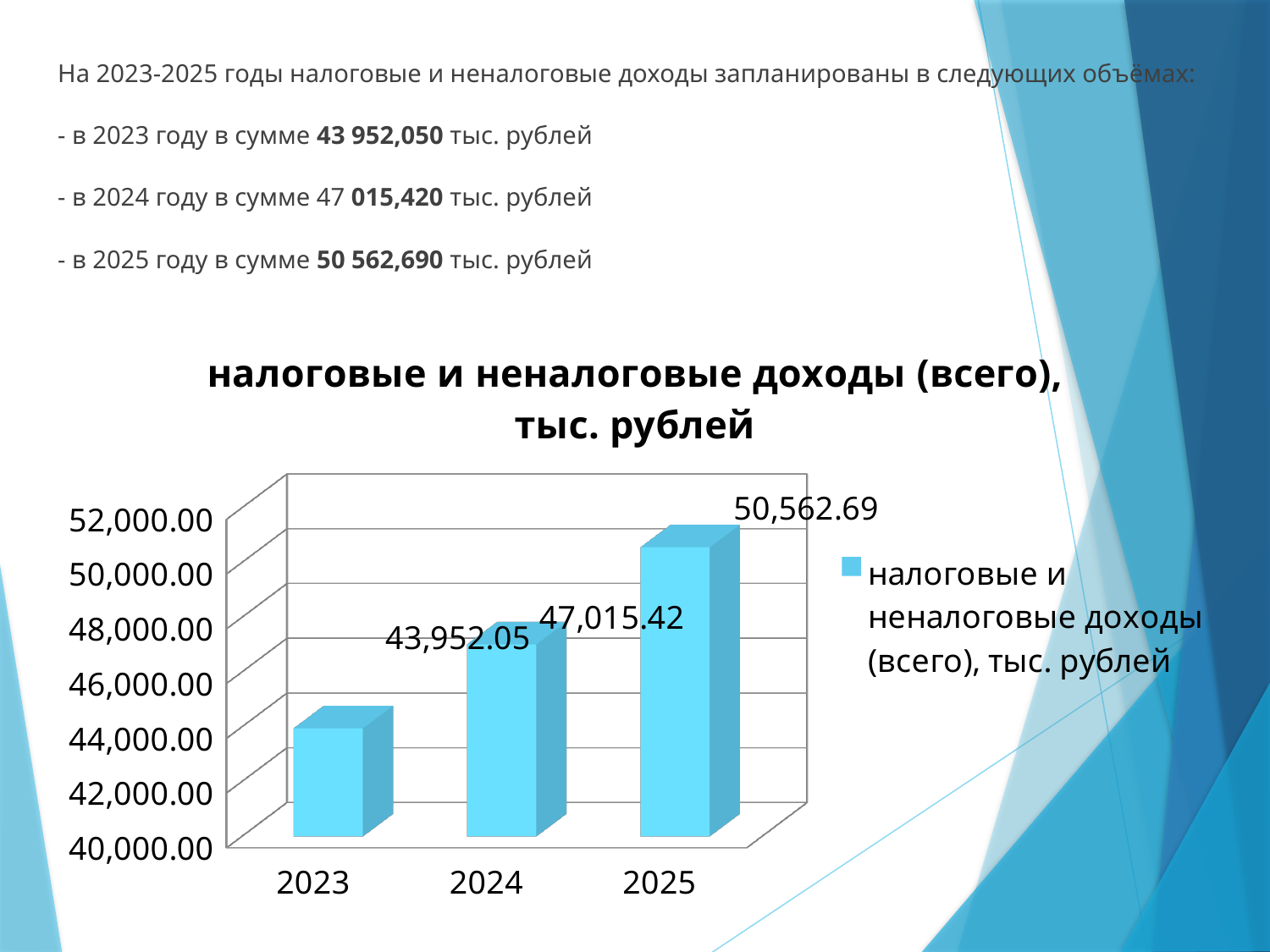
What is the value for 2025 in the chart? 50,562.69 What is the value for 2023 in the chart? 43,952.05 What kind of chart is shown on the slide? bar chart Is the value for 2023 greater or less than 46,000.00? less Do the values rise or fall from 2023 to 2025? rise How many years are shown on the x axis of the chart? 3 What is the value for 2024 in the chart? 47,015.42 What is the difference between the values for 2024 and 2023? 3,063.37 Which year has the highest value in the chart? 2025 Which is larger, the value for 2024 or the value for 2025? 2025 What is the difference between the values for 2025 and 2024? 3,547.27 Which year has the lowest value in the chart? 2023